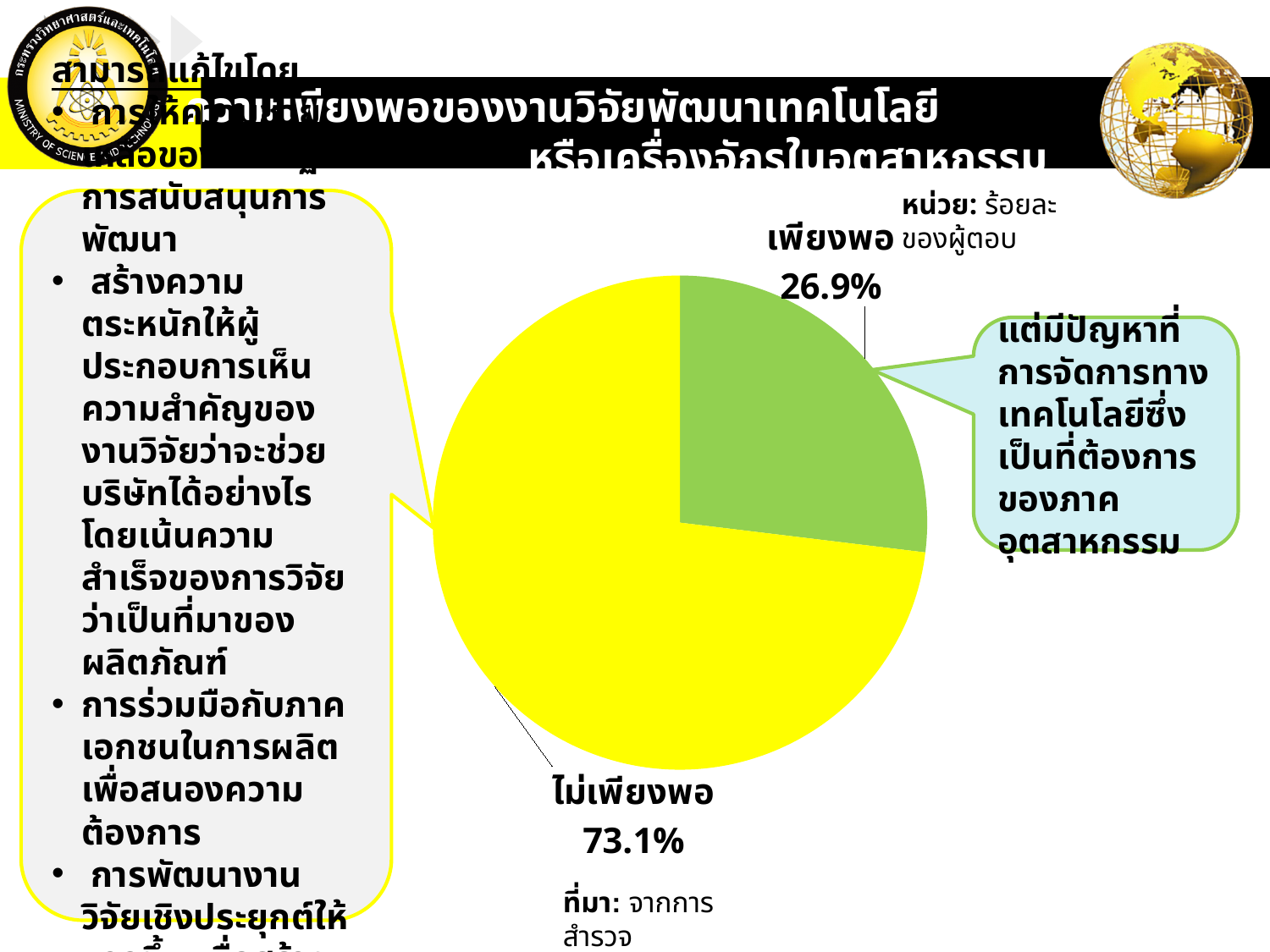
Which slice of the pie chart is the smallest? เพียงพอ What kind of chart is shown on the slide? pie chart What colour is the เพียงพอ slice? green What percentage of respondents answered เพียงพอ? 26.9% What is the difference in percentage points between ไม่เพียงพอ and เพียงพอ? 46.2 Which slice of the pie chart is the largest? ไม่เพียงพอ What percentage of respondents answered ไม่เพียงพอ? 73.1% What share of the pie does the เพียงพอ slice represent? 26.9% What is the total of the two slices in the pie chart? 100% How many slices does the pie chart have? 2 Which is larger, the share for เพียงพอ or the share for ไม่เพียงพอ? ไม่เพียงพอ What colour is the ไม่เพียงพอ slice? yellow